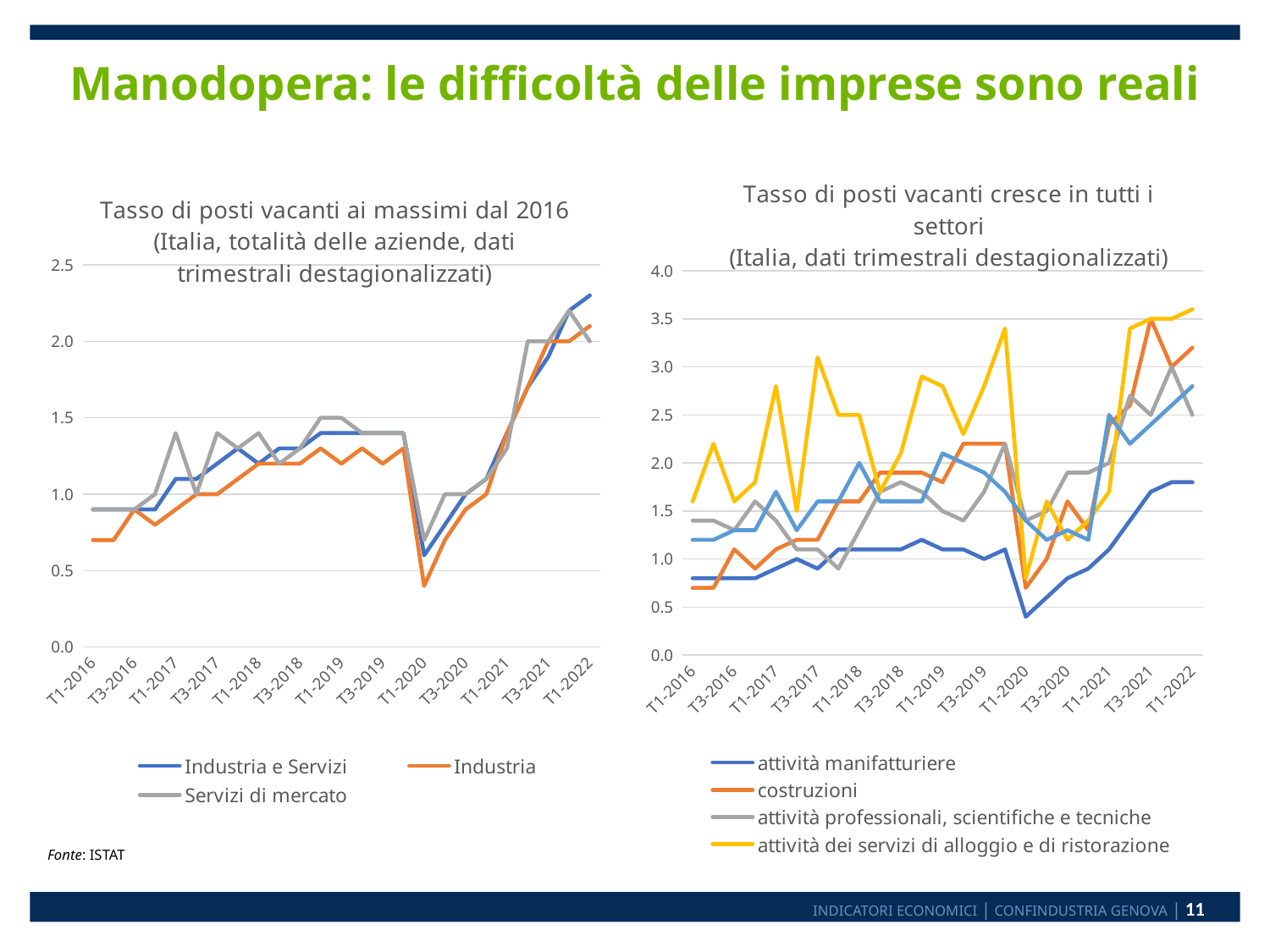
How many series does the legend of the right chart ('Tasso di posti vacanti cresce in tutti i settori') list? 4 In the right chart ('Tasso di posti vacanti cresce in tutti i settori'), is the value for attività dei servizi di alloggio e di ristorazione at T1-2022 greater or less than 3.0? greater What source is cited for the charts on the slide? ISTAT In the right chart ('Tasso di posti vacanti cresce in tutti i settori'), is the value for attività manifatturiere at T1-2020 greater or less than 0.5? less In the left chart ('Tasso di posti vacanti ai massimi dal 2016'), is the value for Industria e Servizi at T1-2022 greater or less than 2.0? greater How many series does the legend of the left chart ('Tasso di posti vacanti ai massimi dal 2016') list? 3 What kind of chart is the left chart, 'Tasso di posti vacanti ai massimi dal 2016'? Line chart In the left chart ('Tasso di posti vacanti ai massimi dal 2016'), does the Industria e Servizi line rise or fall from T1-2021 to T1-2022? Rise In the right chart ('Tasso di posti vacanti cresce in tutti i settori'), which series has the higher value at T1-2022: attività manifatturiere or attività dei servizi di alloggio e di ristorazione? attività dei servizi di alloggio e di ristorazione In the left chart ('Tasso di posti vacanti ai massimi dal 2016'), which series has the higher value at T1-2020: Industria or Servizi di mercato? Servizi di mercato In the right chart ('Tasso di posti vacanti cresce in tutti i settori'), does the attività manifatturiere line rise or fall from T3-2019 to T1-2020? Fall